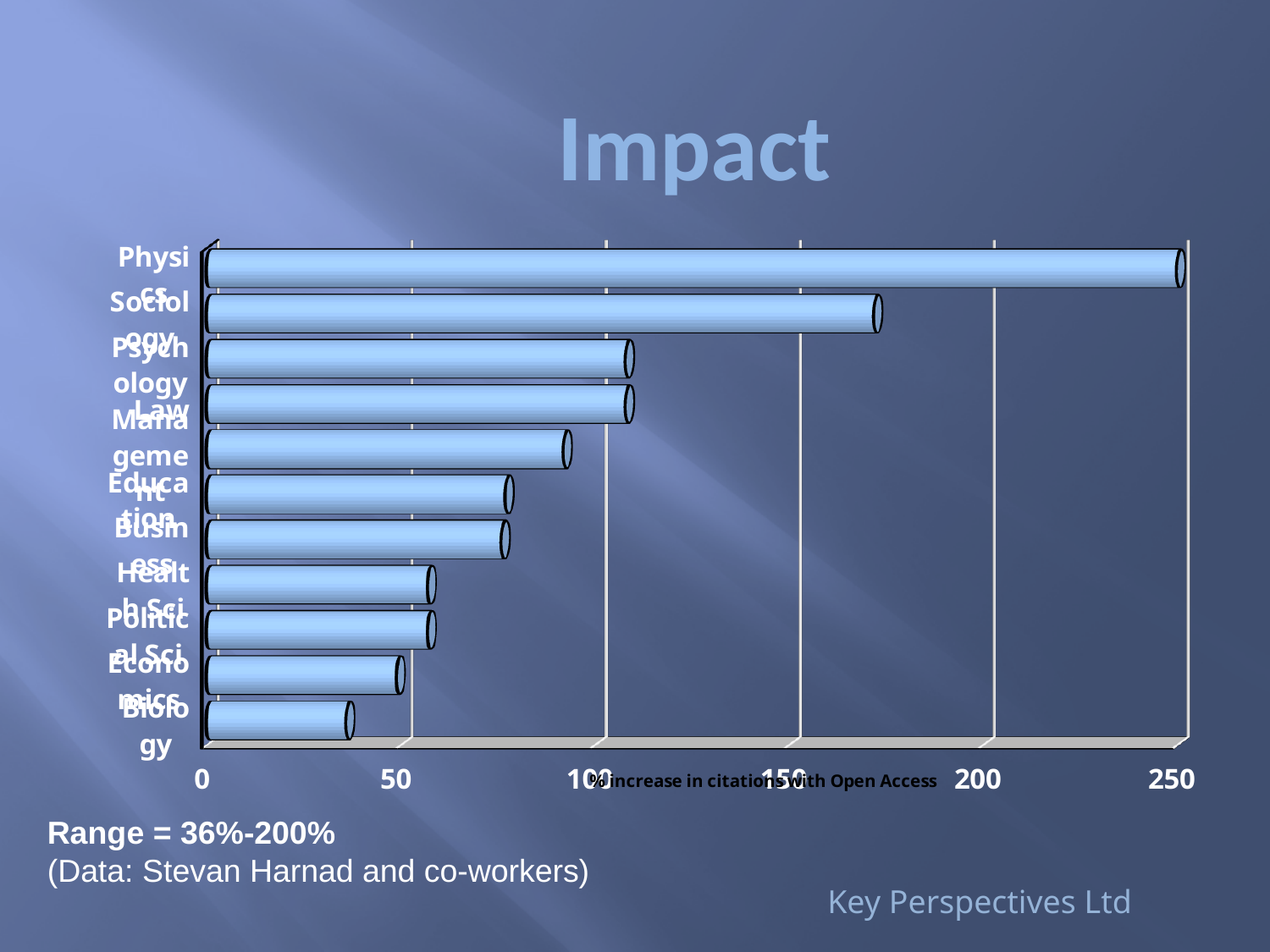
What is the title of the chart? Impact Is the value for Education greater or less than 50? greater Is the value for Biology greater or less than 50? less What is the label on the horizontal axis of the chart? % increase in citations with Open Access Which has a larger value, Economics or Management? Management How many categories (disciplines) are plotted in the chart? 11 Which has a larger value, Sociology or Psychology? Sociology Which discipline has the lowest % increase in citations with Open Access? Biology What kind of chart is shown on the slide? bar chart Is the value for Sociology greater or less than 150? greater Which discipline has the highest % increase in citations with Open Access? Physics